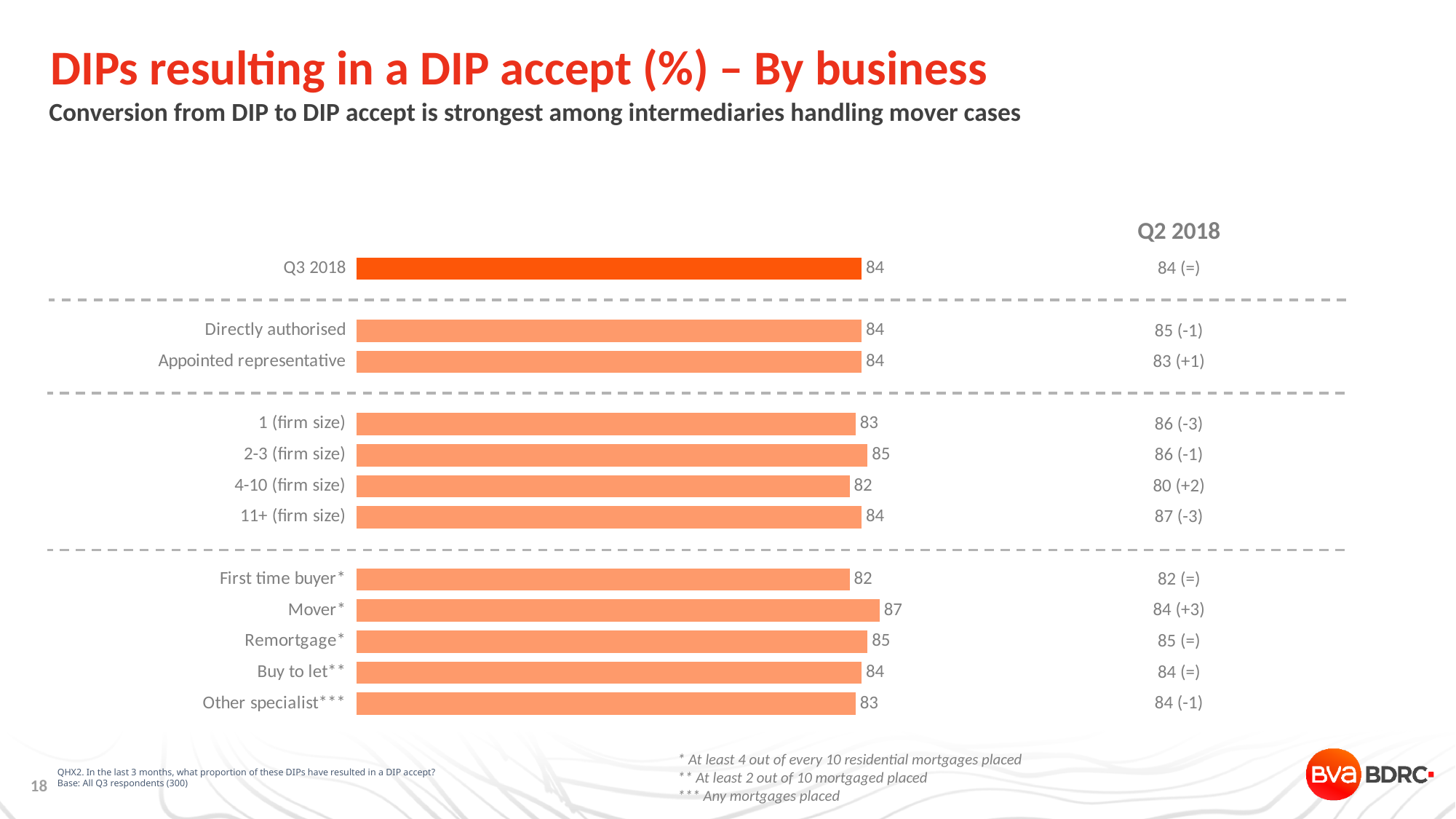
Among the firm size categories, which has the lowest value? 4-10 (firm size) What kind of chart is shown on the slide? Bar chart What is the difference between the values for Mover and First time buyer? 5 What is the value for 4-10 (firm size)? 82 Which is larger, the value for 2-3 (firm size) or the value for 1 (firm size)? 2-3 (firm size) Which category has the highest value in the chart? Mover What is the value for Mover in the chart? 87 What is the Q2 2018 value shown for Mover? 84 (+3) What is the title of the chart on the slide? DIPs resulting in a DIP accept (%) – By business How many bars are plotted in the chart? 12 What is the value for Q3 2018 overall? 84 What is the difference between the values for Remortgage and Other specialist? 2